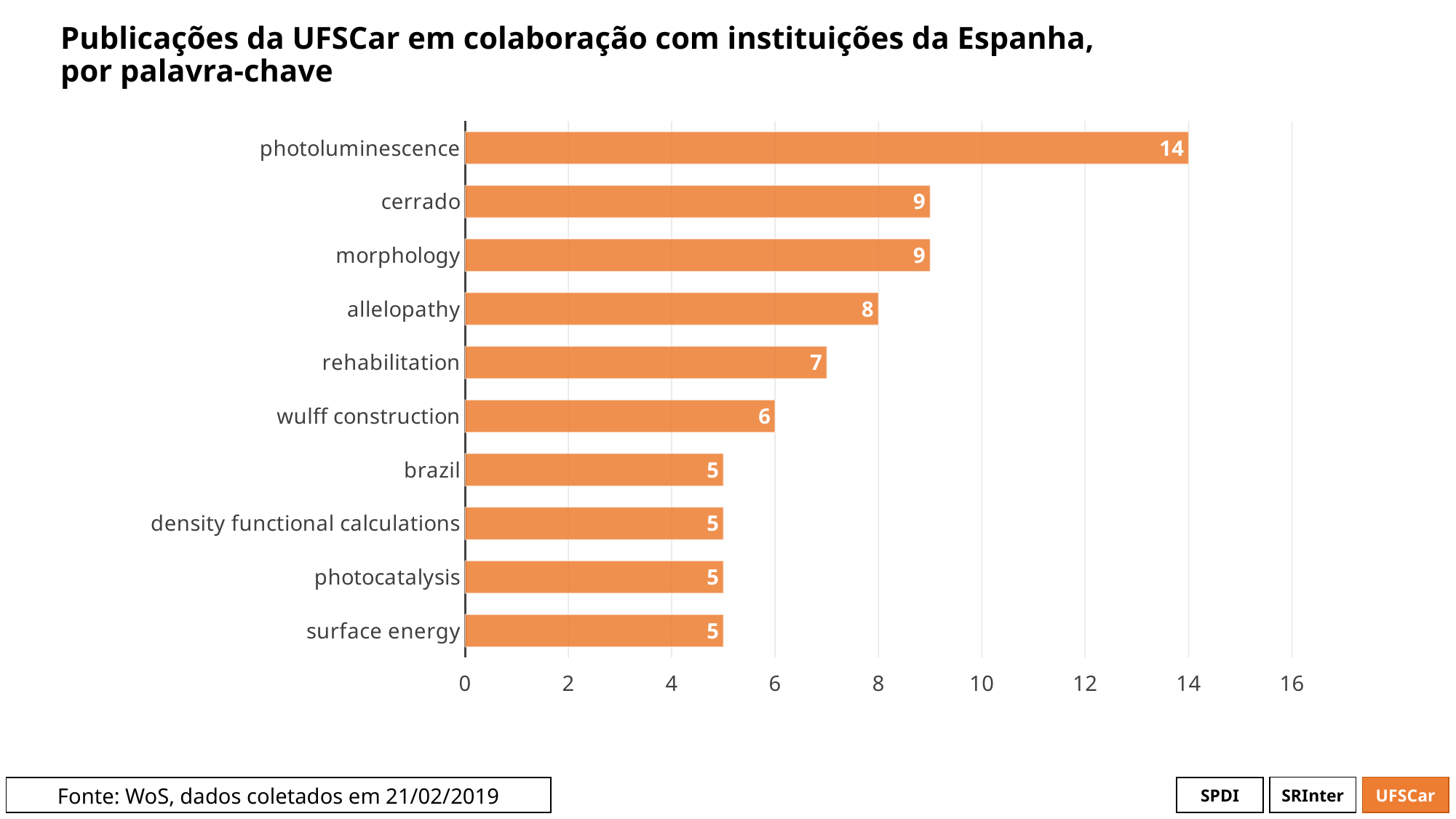
What is the value for rehabilitation? 7 Which keyword has the highest number of publications? photoluminescence What kind of chart is shown on the slide? bar chart What is the difference between the values for allelopathy and brazil? 3 What is the value for photoluminescence? 14 What is the value for wulff construction? 6 How many keywords are shown in the chart? 10 Which is larger, the value for morphology or the value for rehabilitation? morphology What is the source of the data cited on the slide? WoS, dados coletados em 21/02/2019 Is the value for photoluminescence greater or less than 12? greater What is the difference between the values for photoluminescence and cerrado? 5 What is the value for allelopathy? 8